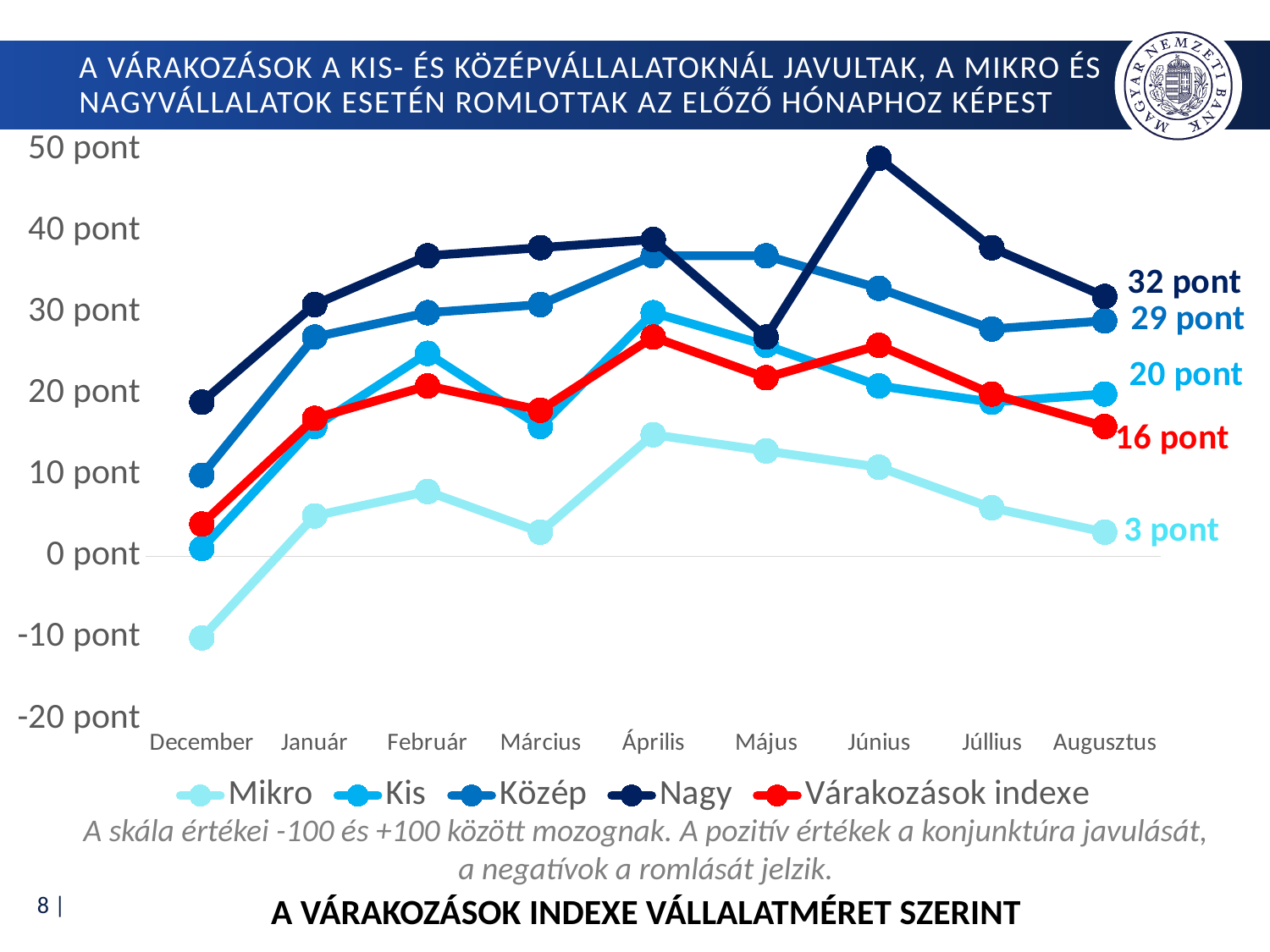
What kind of chart is shown on the slide? line chart What is the value of the Várakozások indexe series in Augusztus? 16 pont Is the value for Nagy in Június greater or less than 40 pont? greater What is the value for Mikro in Augusztus? 3 pont What is the difference between the Nagy and Mikro values in Augusztus? 29 pont In Augusztus, which is larger: the Kis value or the Várakozások indexe value? Kis Which series has the lowest value in Augusztus? Mikro What is the value for Nagy in Augusztus? 32 pont What is the value for Közép in Augusztus? 29 pont How many months are shown on the x axis? 9 Which series has the highest value in Augusztus? Nagy How many series does the legend list? 5